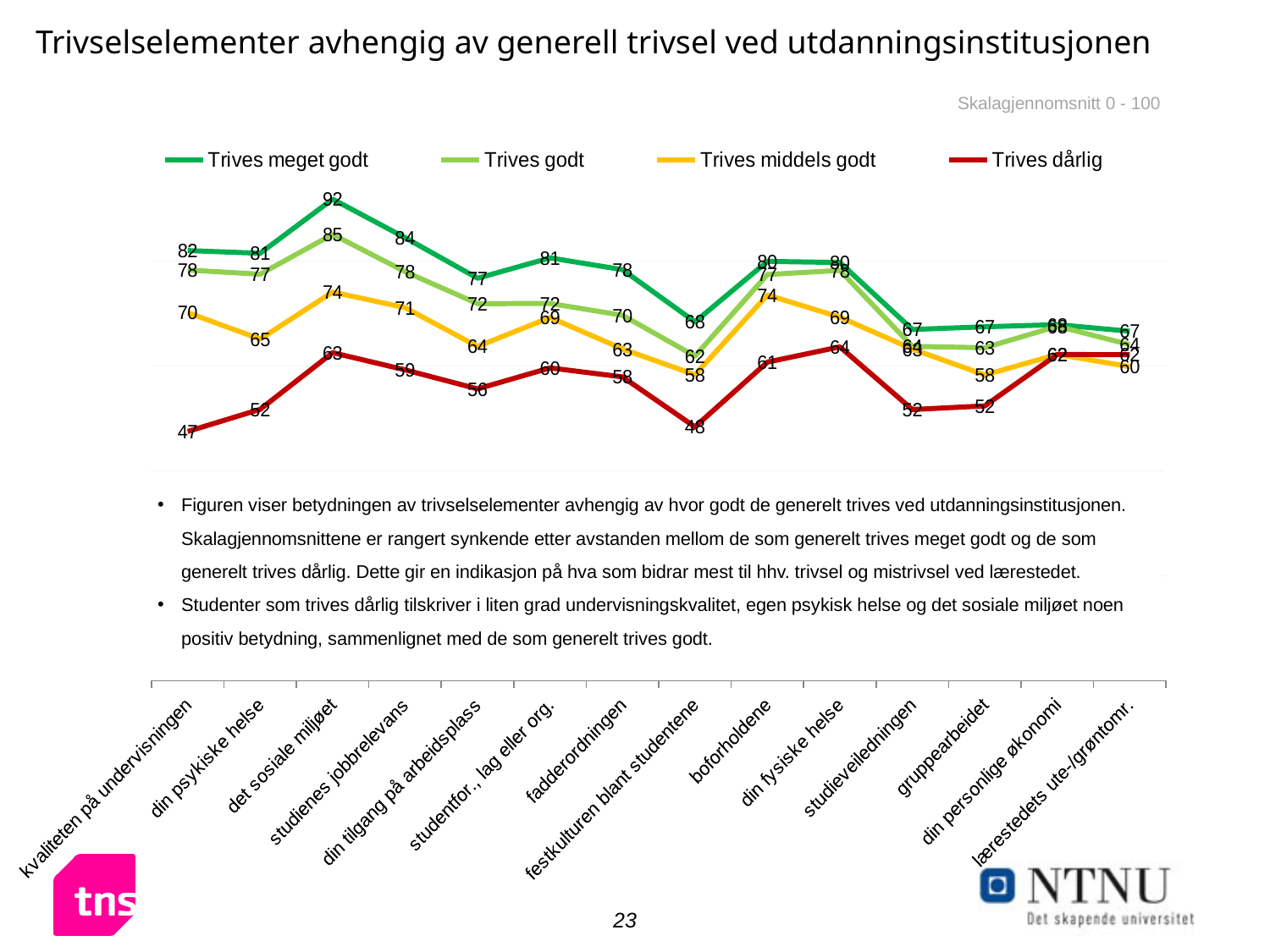
What is the value for 'Trives godt' at 'festkulturen blant studentene'? 62 What is the value for 'Trives dårlig' at 'kvaliteten på undervisningen'? 47 For which category is the 'Trives dårlig' series lowest? kvaliteten på undervisningen What is the value for 'Trives middels godt' at 'boforholdene'? 74 How many series does the legend list? 4 What is the value for 'Trives meget godt' at 'det sosiale miljøet'? 92 For which category is the 'Trives meget godt' series highest? det sosiale miljøet What colour is the 'Trives dårlig' line in the legend? Red What is the difference between 'Trives meget godt' and 'Trives dårlig' at 'kvaliteten på undervisningen'? 35 What type of chart is shown on the slide? Line chart Which is larger for 'Trives dårlig': the value at 'din psykiske helse' or at 'det sosiale miljøet'? det sosiale miljøet How many categories are plotted along the x axis? 14